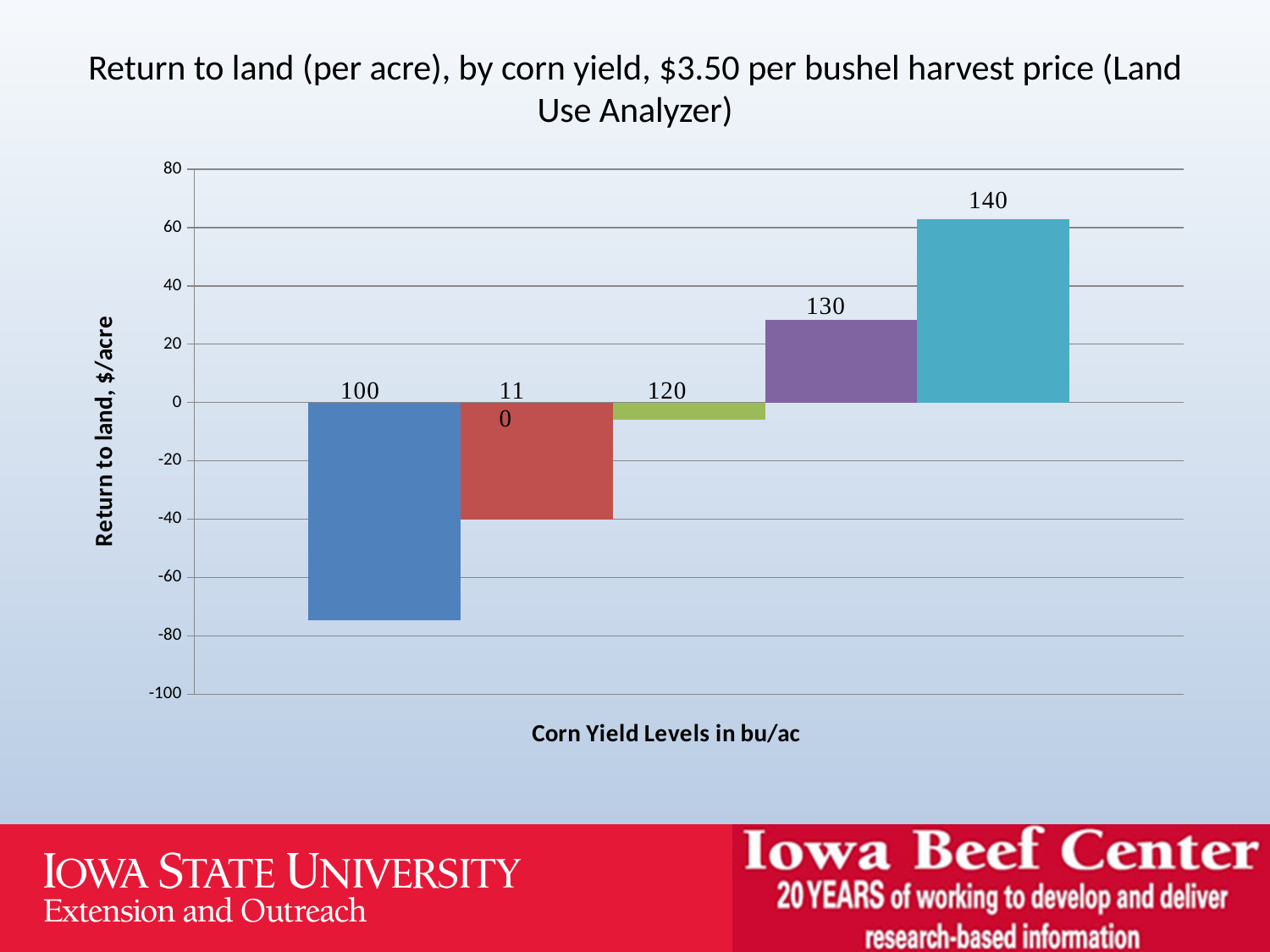
Is the return to land for the 130 bu/ac yield level greater or less than 20? greater Which corn yield level has the lowest return to land? 100 Do the return to land values rise or fall as corn yield increases along the x axis? rise What is the title of the horizontal axis? Corn Yield Levels in bu/ac Which has a larger return to land, the 130 or the 140 bu/ac yield level? 140 Is the return to land for the 140 bu/ac yield level greater or less than 40? greater How many corn yield levels are plotted in the chart? 5 What kind of chart is shown on the slide? bar chart Which corn yield level has the highest return to land? 140 What is the title of the vertical axis? Return to land, $/acre Is the return to land for the 120 bu/ac yield level greater or less than -20? greater